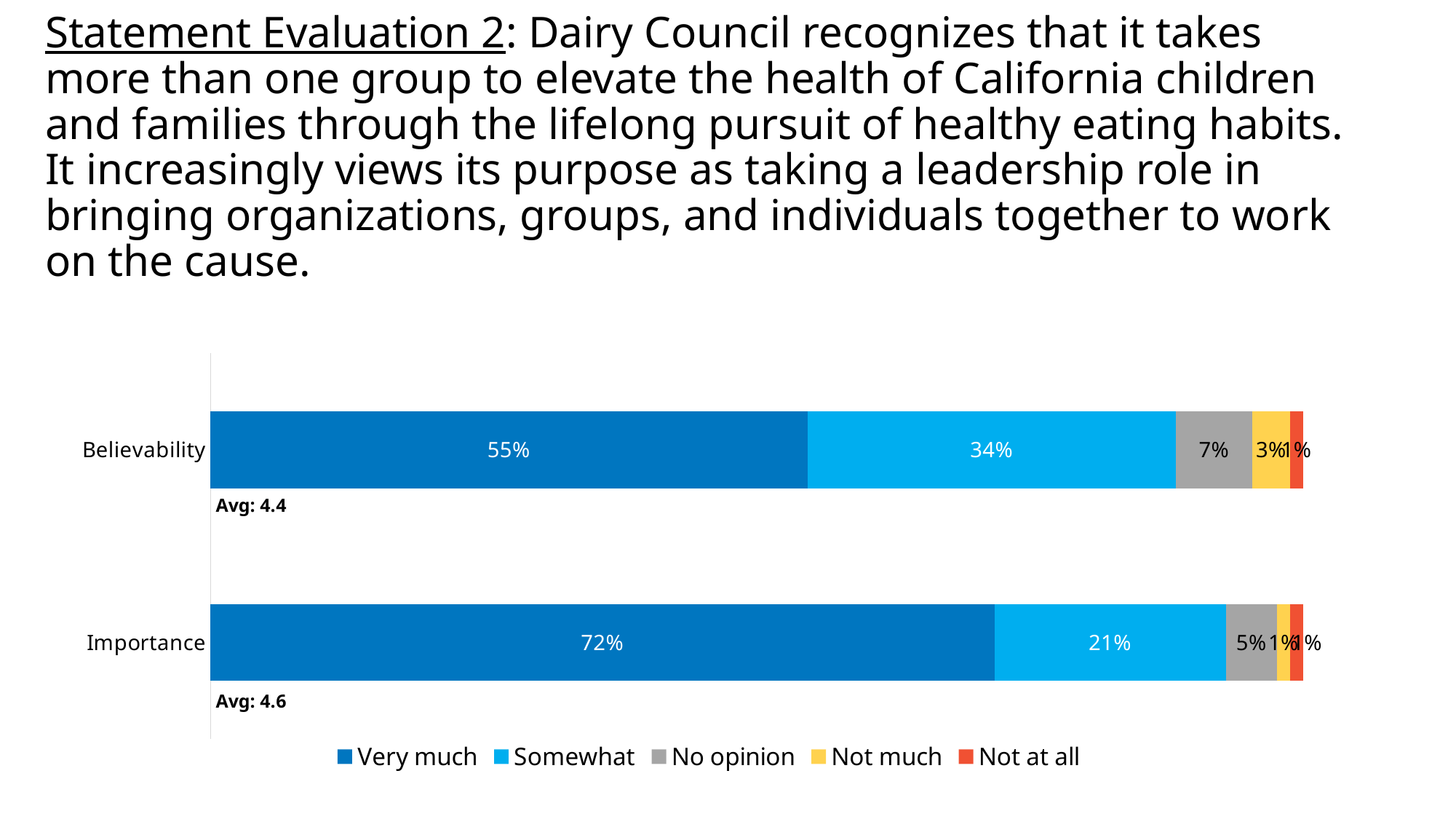
How many categories are plotted on the chart? 2 What is the difference between the "Somewhat" values for Believability and Importance? 13% Which category has the higher "Very much" share, Believability or Importance? Importance What is the "No opinion" value for Believability? 7% What is the average score shown for Importance? 4.6 What is the difference between the "Very much" values for Importance and Believability? 17% What type of chart is shown on the slide? Stacked bar chart What percentage of respondents answered "Very much" for Believability? 55% What is the "Not much" value for Believability? 3% What percentage of respondents answered "Somewhat" for Importance? 21% Which legend entry is shown in red? Not at all How many series does the legend list? 5